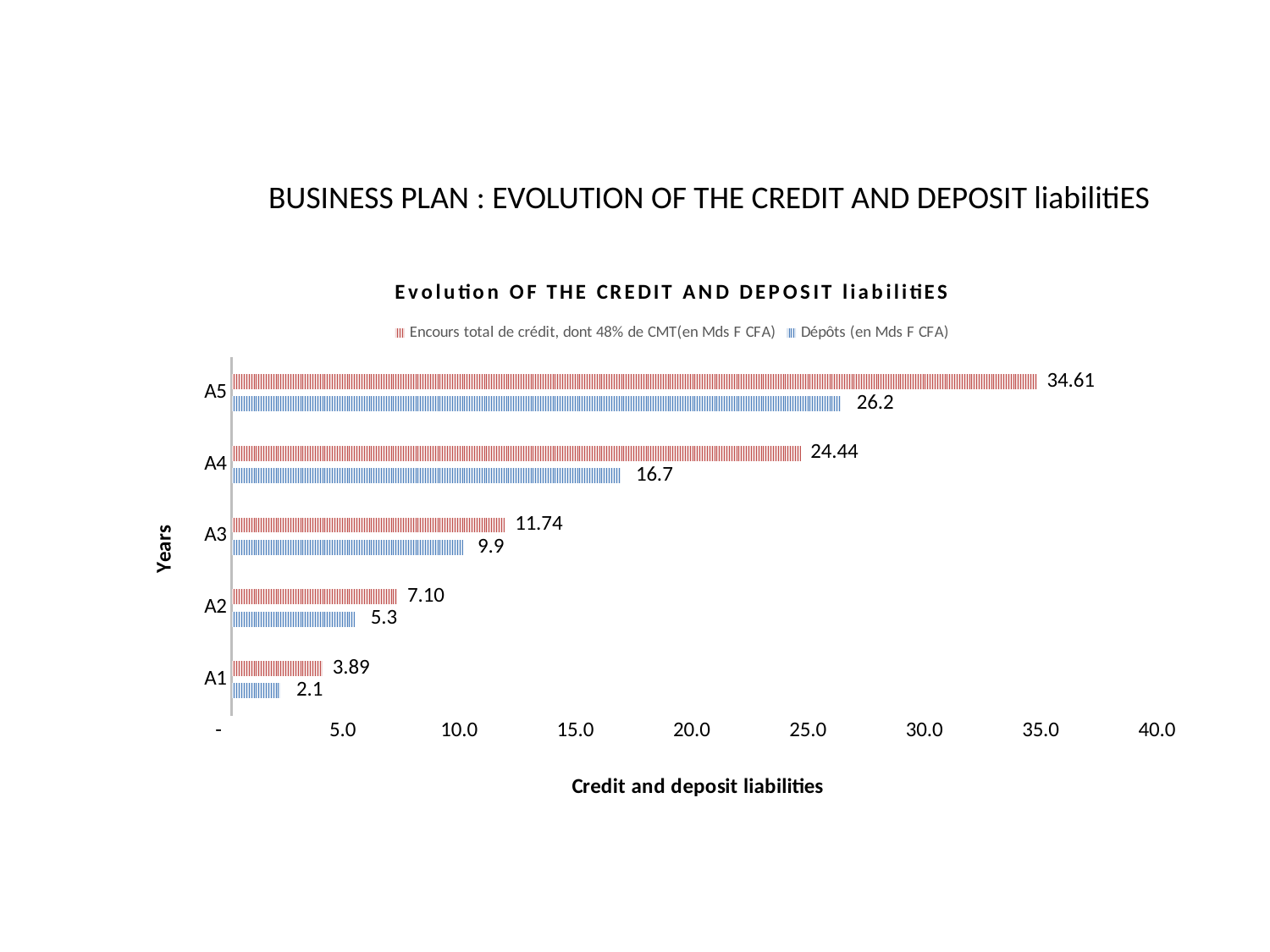
Which year has the lowest value for 'Encours total de crédit, dont 48% de CMT(en Mds F CFA)'? A1 What is the value of 'Dépôts (en Mds F CFA)' for A1? 2.1 Which year has the highest value for 'Dépôts (en Mds F CFA)'? A5 What kind of chart is shown on the slide? Bar chart Do the 'Dépôts (en Mds F CFA)' values rise or fall from A1 to A5? Rise What is the value of 'Dépôts (en Mds F CFA)' for A3? 9.9 Which is larger for A3: the 'Encours total de crédit' value or the 'Dépôts' value? Encours total de crédit What is the value of 'Encours total de crédit, dont 48% de CMT(en Mds F CFA)' for A2? 7.10 How many years are shown on the chart? 5 What is the value of 'Encours total de crédit, dont 48% de CMT(en Mds F CFA)' for A5? 34.61 How many series does the legend list? 2 What is the difference between the 'Encours total de crédit' value and the 'Dépôts' value for A4? 7.74